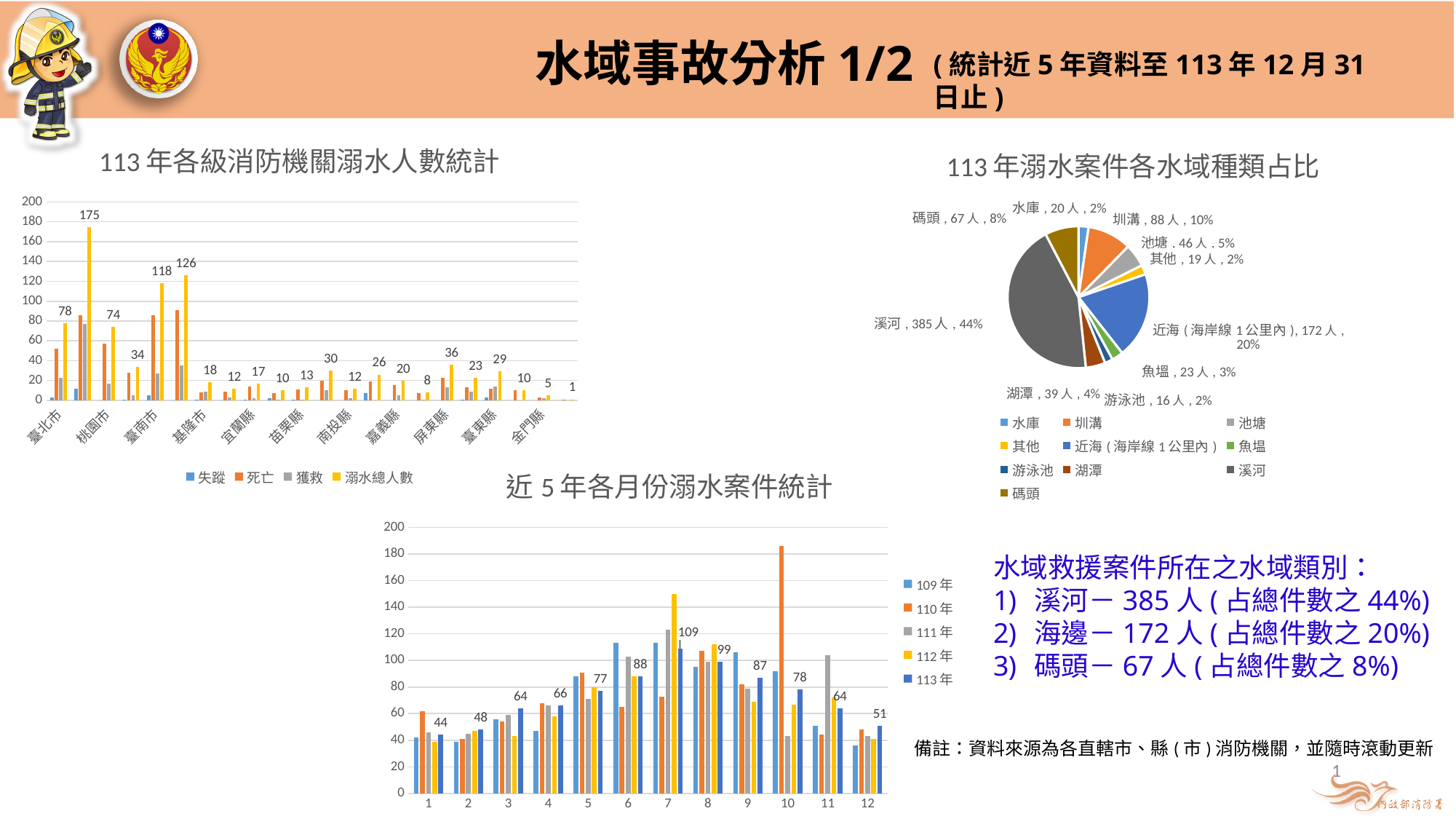
In the chart titled 113年各級消防機關溺水人數統計, what is the highest 溺水總人數 data label shown? 175 How many slices does the pie chart titled 113年溺水案件各水域種類占比 have? 10 How many series does the legend of the chart titled 113年各級消防機關溺水人數統計 list? 4 In the chart titled 近5年各月份溺水案件統計, is the 110年 value for month 10 greater or less than 180? greater In the chart titled 113年各級消防機關溺水人數統計, which has a larger 溺水總人數, 臺北市 or 金門縣? 臺北市 In the pie chart titled 113年溺水案件各水域種類占比, which category has the smallest number of people? 游泳池 In the pie chart titled 113年溺水案件各水域種類占比, what is the difference in people between 圳溝 and 碼頭? 21人 In the pie chart titled 113年溺水案件各水域種類占比, how many people are attributed to 近海(海岸線1公里內)? 172人 In the chart titled 近5年各月份溺水案件統計, what is the 113年 value for month 7? 109 In the chart titled 113年各級消防機關溺水人數統計, what is the 溺水總人數 value for 屏東縣? 36 In the pie chart titled 113年溺水案件各水域種類占比, what share does 溪河 have? 44% In the chart titled 113年各級消防機關溺水人數統計, what is the 溺水總人數 value for 臺北市? 78